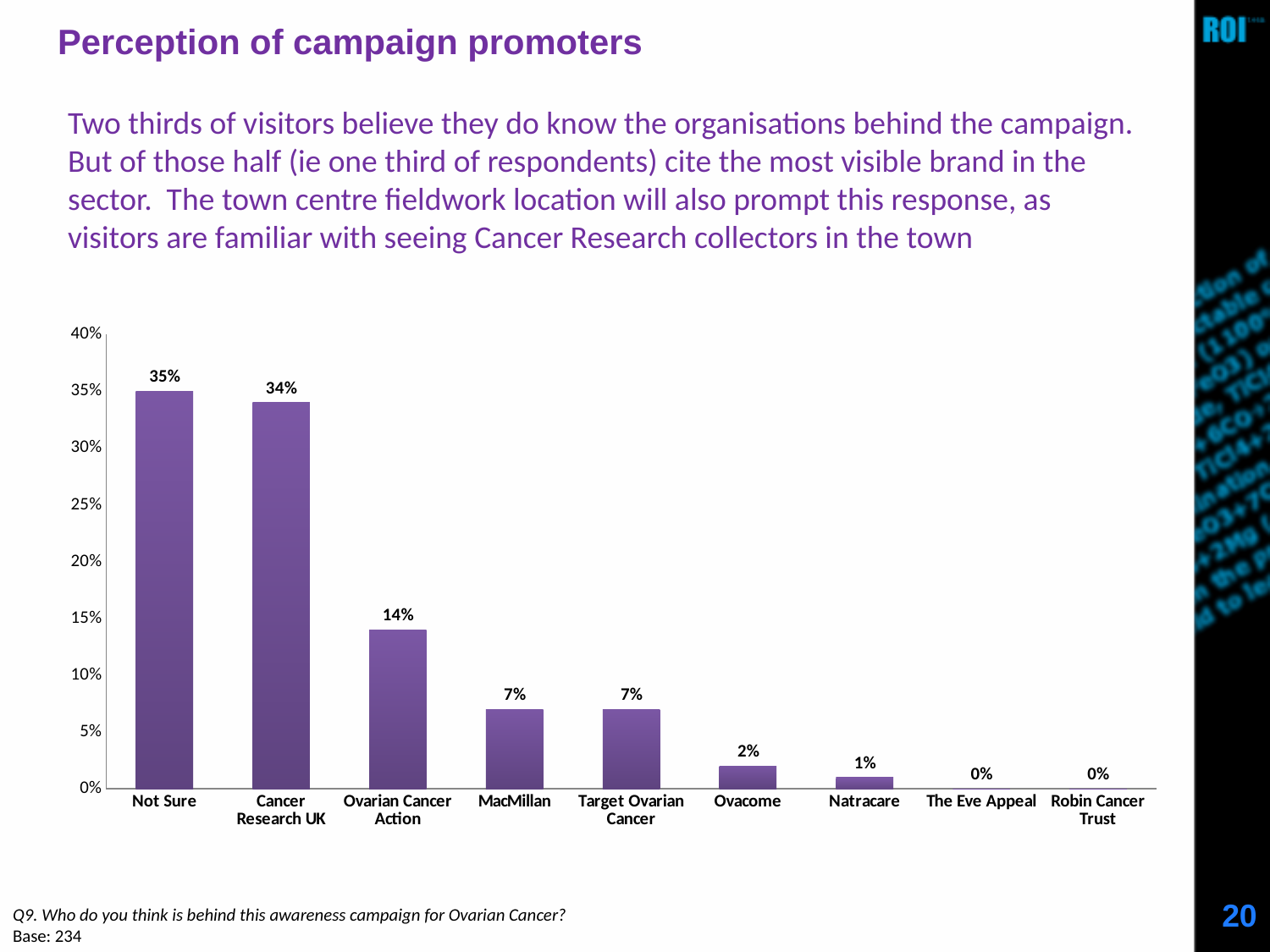
Which category has the highest value? Not Sure What is the value for Cancer Research UK? 34% Do the values rise or fall moving from left to right along the x axis? fall What is the difference between the values for Not Sure and Cancer Research UK? 1% What is the value for Ovacome? 2% How many categories are shown on the x axis? 9 Which is larger, the value for Ovarian Cancer Action or the value for Target Ovarian Cancer? Ovarian Cancer Action What is the difference between the values for Ovarian Cancer Action and MacMillan? 7% What is the value for Natracare? 1% Is the value for Cancer Research UK greater or less than 30%? greater What is the value for Ovarian Cancer Action? 14% What kind of chart is shown on the slide? bar chart